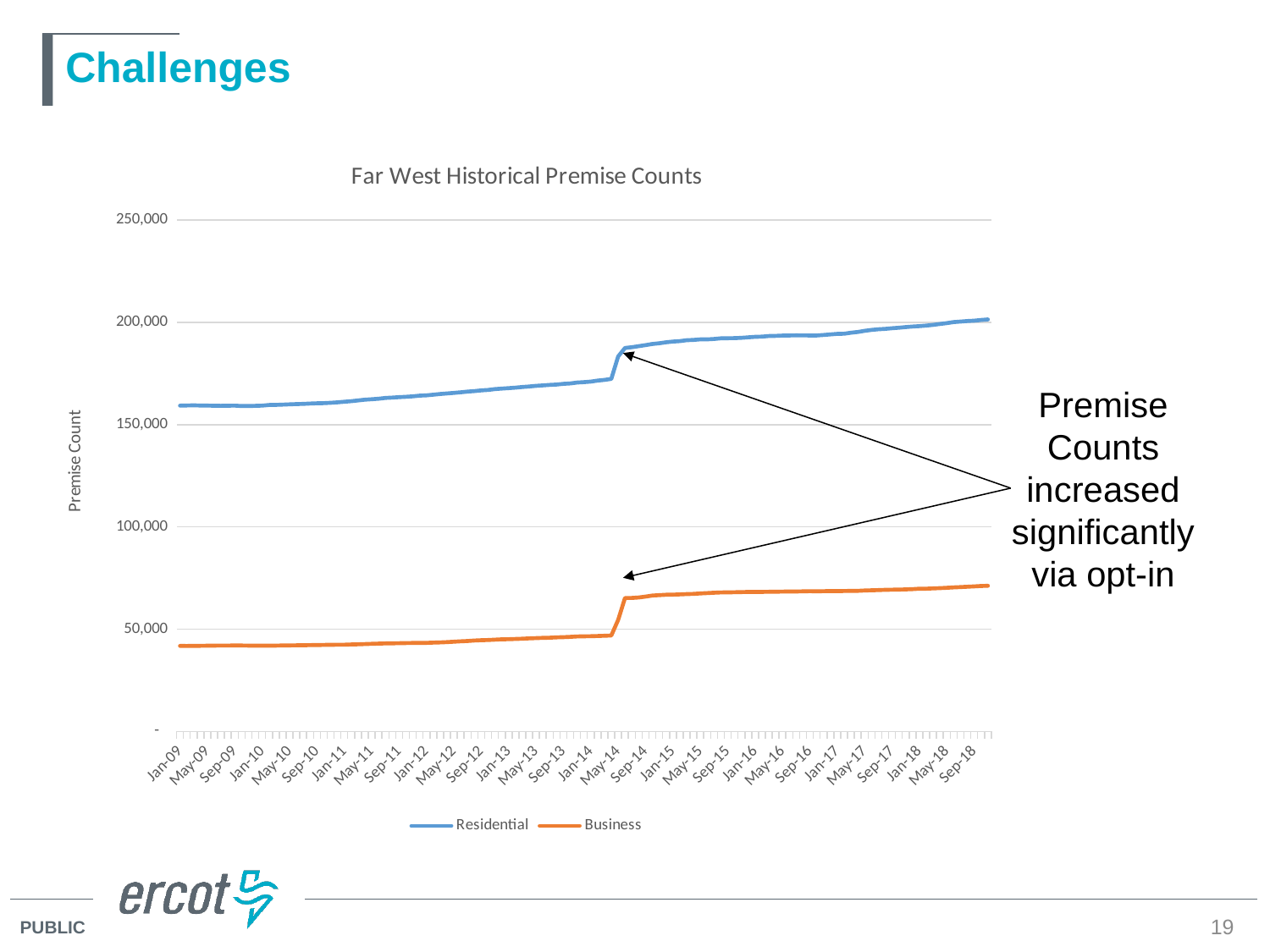
What is the title of the chart? Far West Historical Premise Counts Is the Residential value at Jan-14 greater or less than 200,000? less Does the Business series rise or fall from Jan-09 to Sep-18? rise Is the Residential value at Jan-09 greater or less than 150,000? greater Is the Business value at Sep-18 greater or less than 50,000? greater Which series is drawn in orange? Business What kind of chart is shown on the slide? line chart How many series does the legend list? 2 Which series has the higher premise count throughout the chart, Residential or Business? Residential Does the Residential series rise or fall from Jan-09 to Sep-18? rise